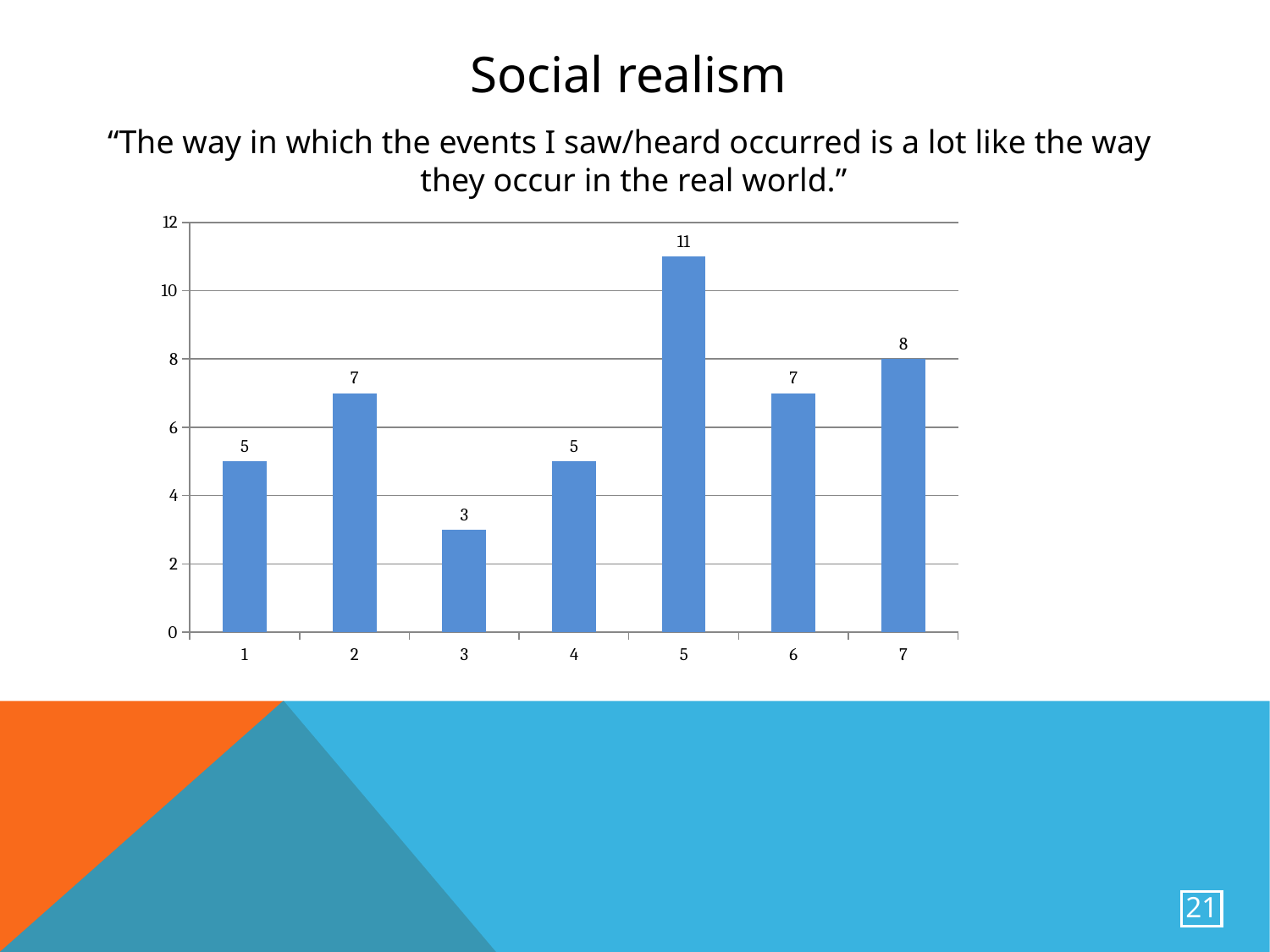
Which is larger, the value for category 2 or the value for category 4? category 2 Which category has the lowest value? 3 Is the value for category 5 greater or less than 10? greater What is the value for category 3? 3 What is the value for category 5? 11 What is the value for category 7? 8 How many categories are shown on the x axis? 7 What is the difference between the values for category 7 and category 1? 3 Which category has the highest value? 5 What is the difference between the values for category 5 and category 3? 8 What is the title of the slide containing the chart? Social realism What kind of chart is shown on the slide? bar chart